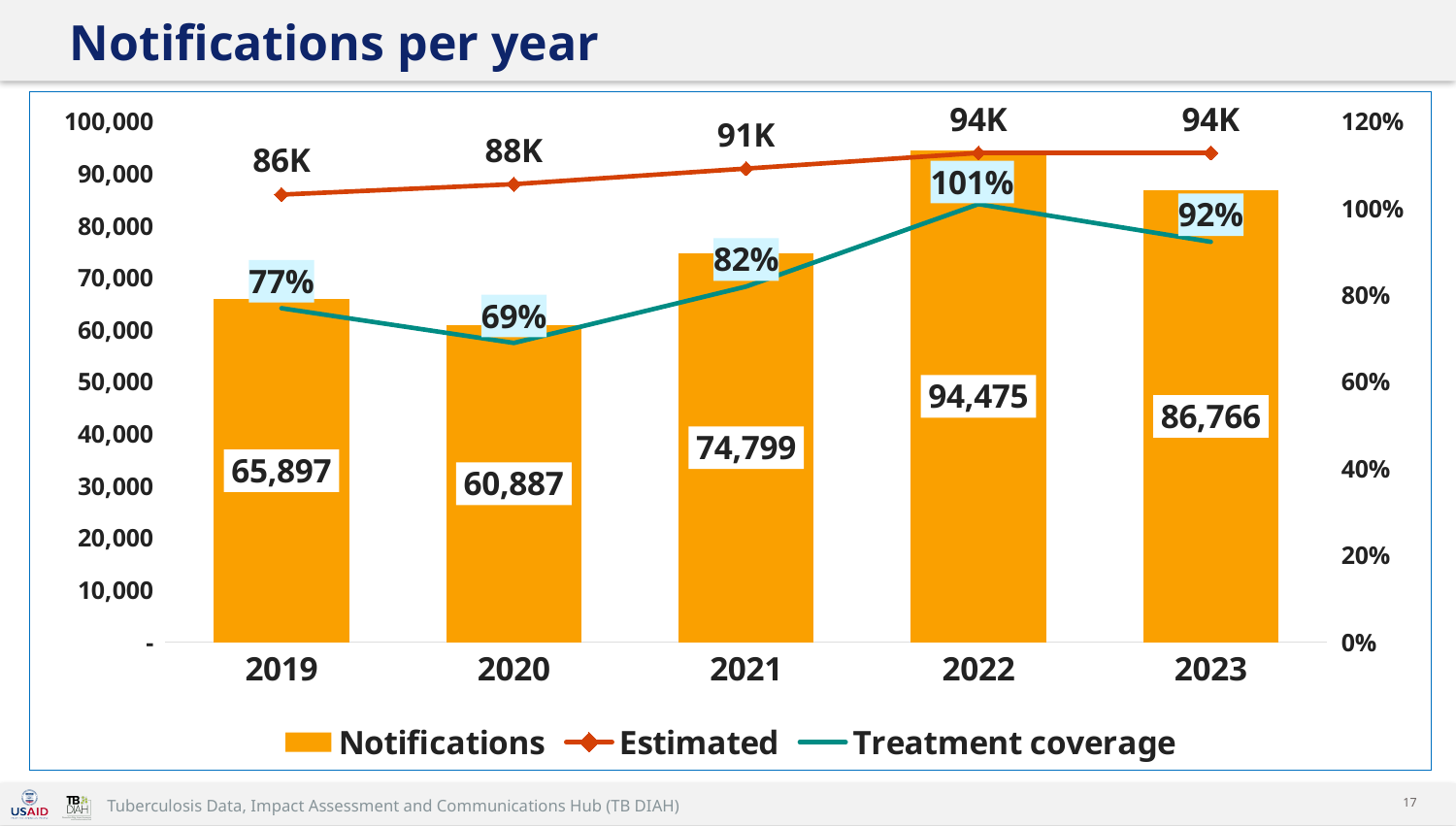
Did Notifications rise or fall from 2020 to 2022? rise What is the Treatment coverage for 2020? 69% What is the value of Notifications for 2022? 94,475 Which is larger, the Notifications value for 2019 or for 2021? 2021 How many years are shown on the x axis? 5 Which year has the highest Notifications value? 2022 Which year has the lowest Treatment coverage? 2020 Is the Notifications value for 2020 greater or less than 70,000? less What is the difference in Notifications between 2022 and 2023? 7,709 What is the Estimated value for 2021? 91K How many series does the legend list? 3 Which series is shown as orange bars? Notifications